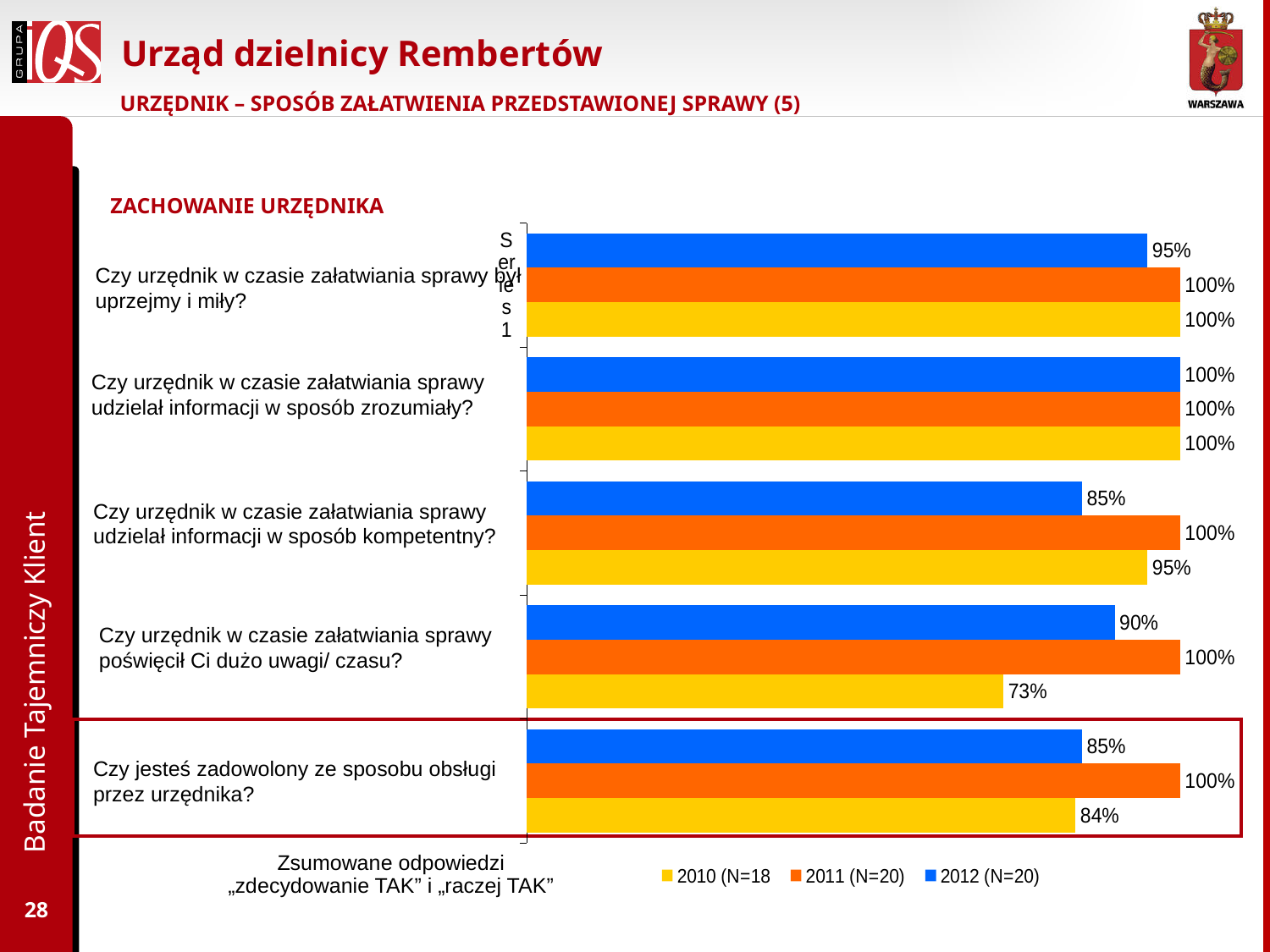
What is the 2010 value for "Czy urzędnik w czasie załatwiania sprawy poświęcił Ci dużo uwagi/ czasu?"? 73% What kind of chart is shown on the slide? Bar chart What is the 2012 value for "Czy urzędnik w czasie załatwiania sprawy udzielał informacji w sposób kompetentny?"? 85% What is the 2012 value for "Czy urzędnik w czasie załatwiania sprawy był uprzejmy i miły?"? 95% What is the difference between the 2012 and 2010 values for "Czy urzędnik w czasie załatwiania sprawy udzielał informacji w sposób kompetentny?"? 10% How many series does the legend list? 3 What is the 2010 value for "Czy jesteś zadowolony ze sposobu obsługi przez urzędnika?"? 84% For "Czy jesteś zadowolony ze sposobu obsługi przez urzędnika?", which is larger: the 2012 value or the 2010 value? 2012 How many questions (categories) are shown on the chart? 5 What is the difference between the 2011 and 2010 values for "Czy urzędnik w czasie załatwiania sprawy poświęcił Ci dużo uwagi/ czasu?"? 27% Which question has the lowest 2010 value? Czy urzędnik w czasie załatwiania sprawy poświęcił Ci dużo uwagi/ czasu? Which colour represents the 2011 (N=20) series in the legend? Orange